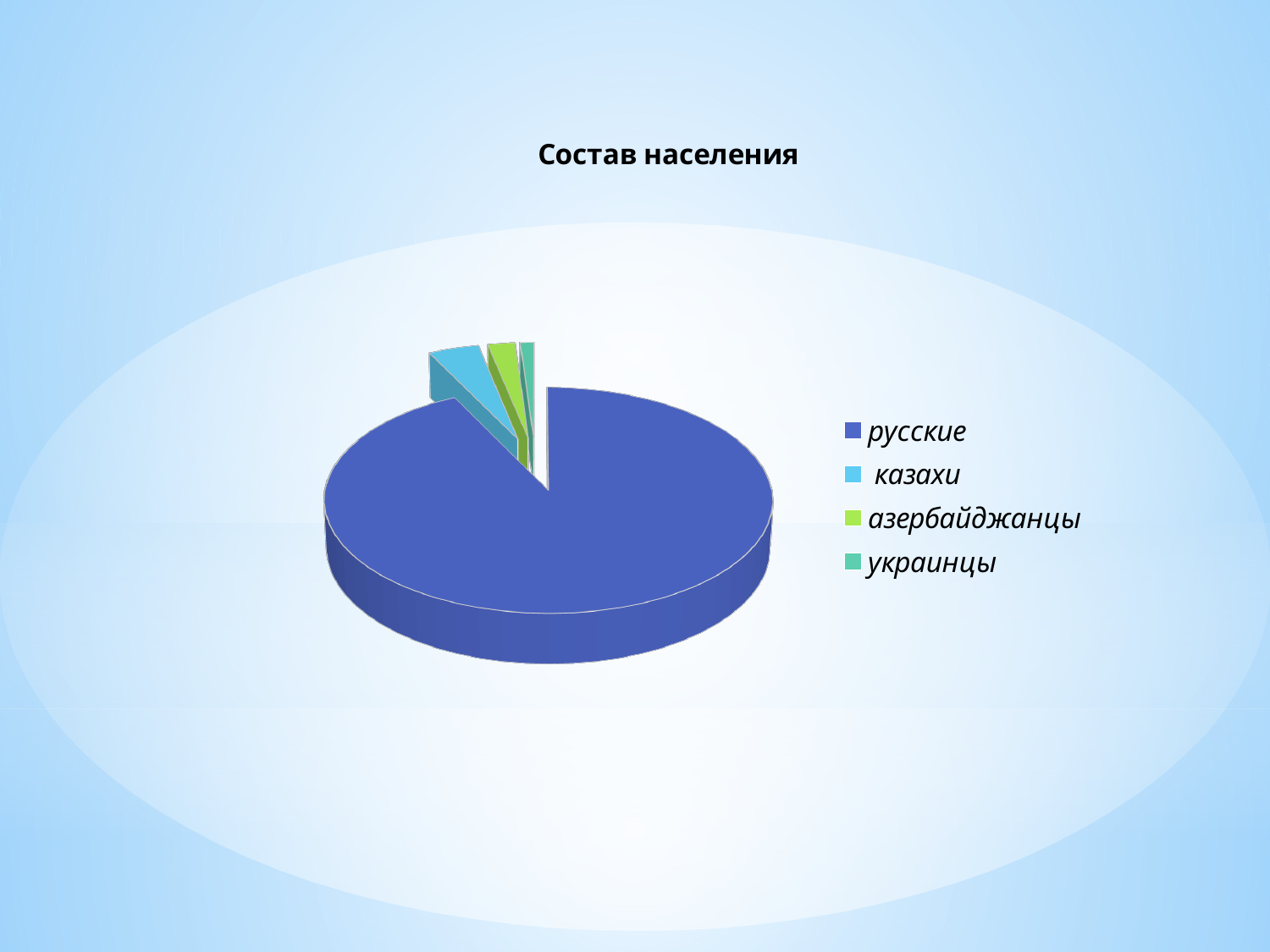
Which category has the largest slice of the pie? русские Which slice is larger, казахи or украинцы? казахи What is the title of the chart? Состав населения Which slice is larger, русские or казахи? русские What kind of chart is shown on the slide? pie chart Which category is the second largest slice of the pie? казахи How many categories does the legend of the chart list? 4 Which legend entry is listed last in the chart's legend? украинцы